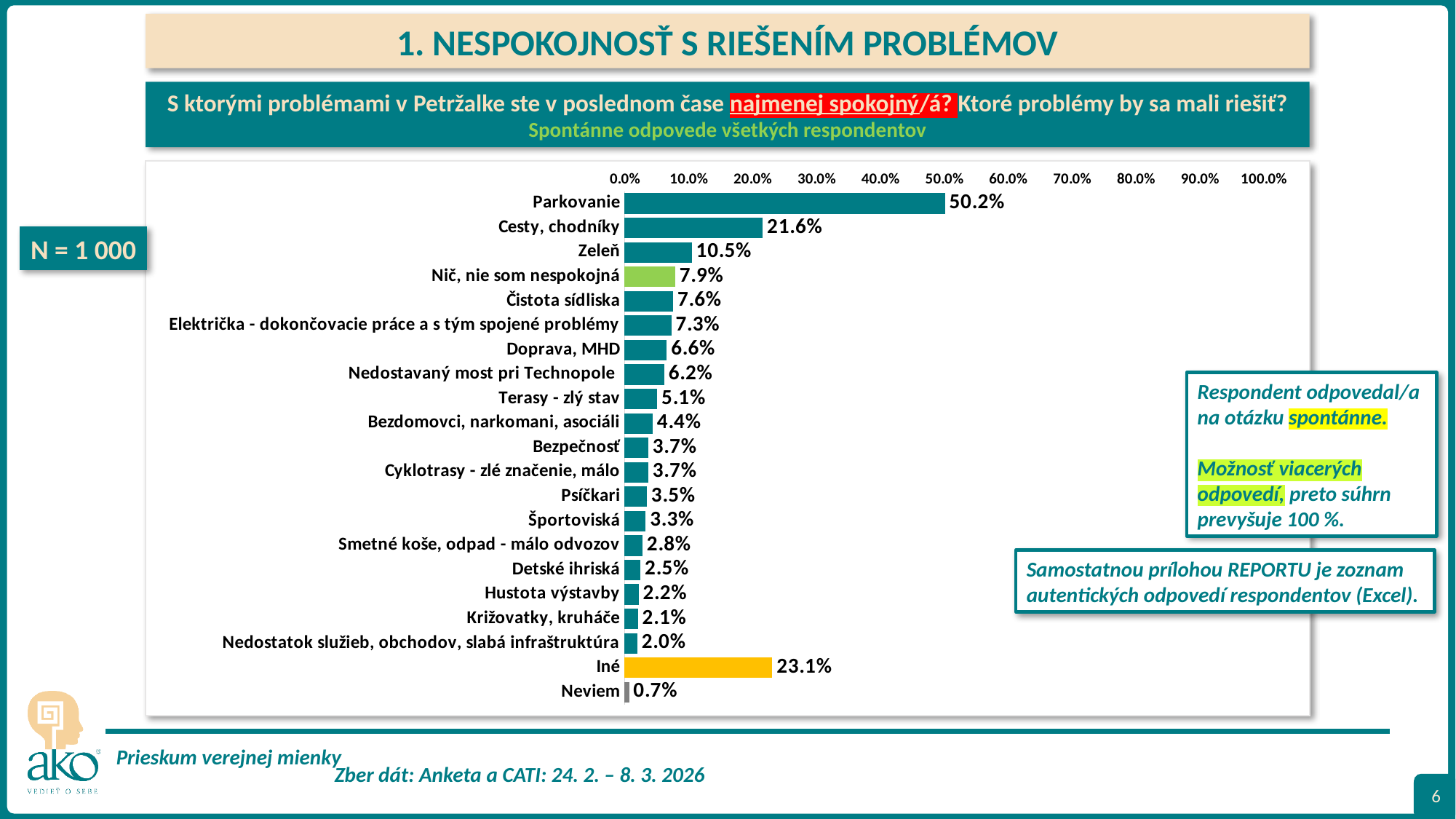
What is the difference between the values for Parkovanie and Cesty, chodníky? 28.6% What colour is the bar for Iné? orange What is the value for Nič, nie som nespokojná? 7.9% What is the value for Iné? 23.1% Which category has the lowest value? Neviem Which is larger, the value for Zeleň or the value for Doprava, MHD? Zeleň What kind of chart is shown on the slide? bar chart Is the value for Parkovanie greater or less than 40.0%? greater What is the value for Cesty, chodníky? 21.6% Which category has the highest value? Parkovanie What is the value for Parkovanie? 50.2% How many categories are shown in the chart? 21